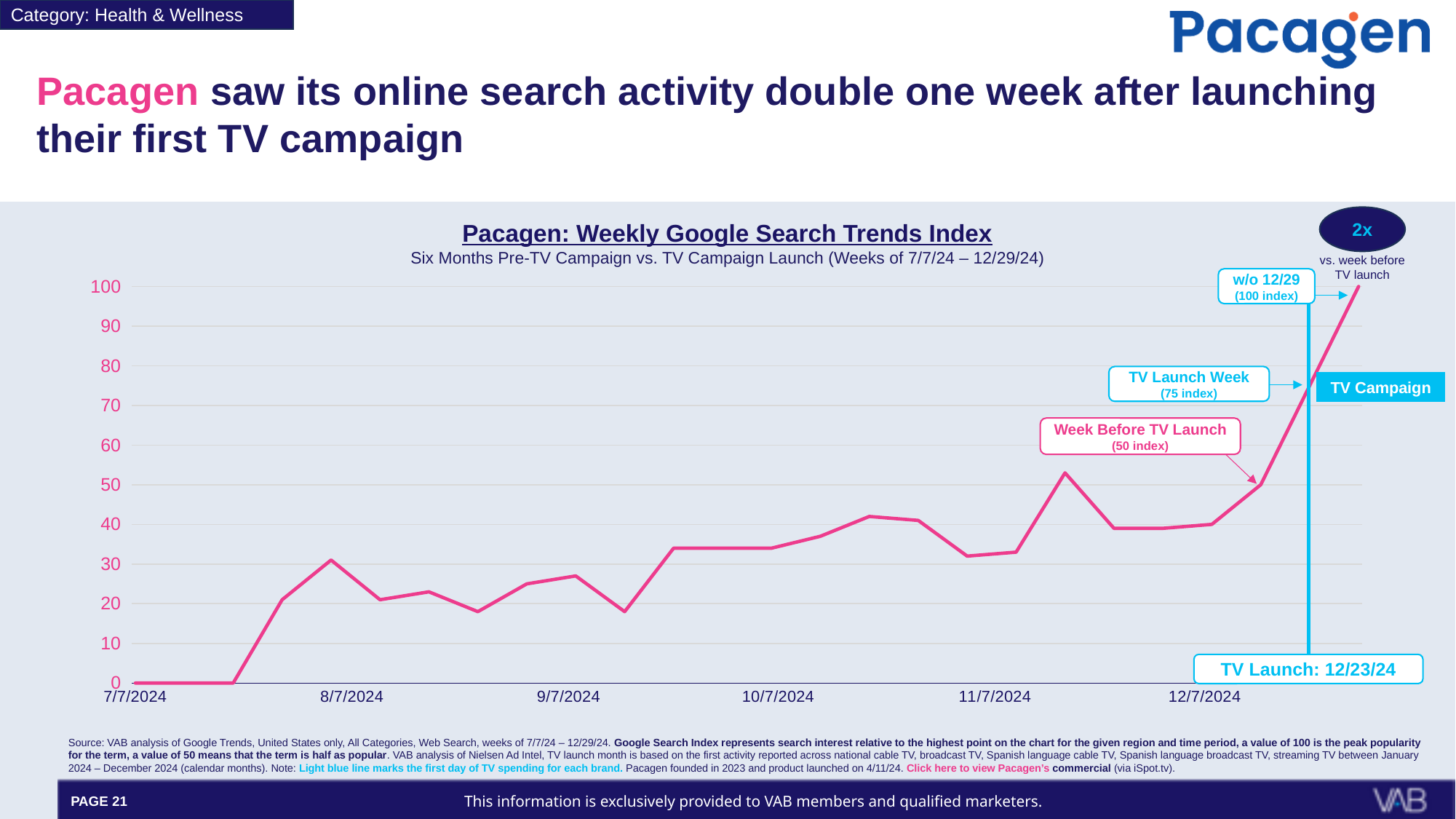
What is the difference between the TV Launch Week index and the Week Before TV Launch index? 25 What is the search index value for the TV Launch Week? 75 What is the search index value for the Week Before TV Launch? 50 Which is larger, the index for the TV Launch Week or the index for the Week Before TV Launch? TV Launch Week What is the search index value for the week of 12/29 (w/o 12/29)? 100 What is the title of the chart? Pacagen: Weekly Google Search Trends Index Is the search index value at 7/7/2024 greater or less than 10? less Which week has the highest search index value on the chart? w/o 12/29 What kind of chart is shown on the slide? line chart Is the search index value at 8/7/2024 greater or less than 20? greater What is the difference between the index for w/o 12/29 and the index for the Week Before TV Launch? 50 What TV launch date is marked on the chart? 12/23/24